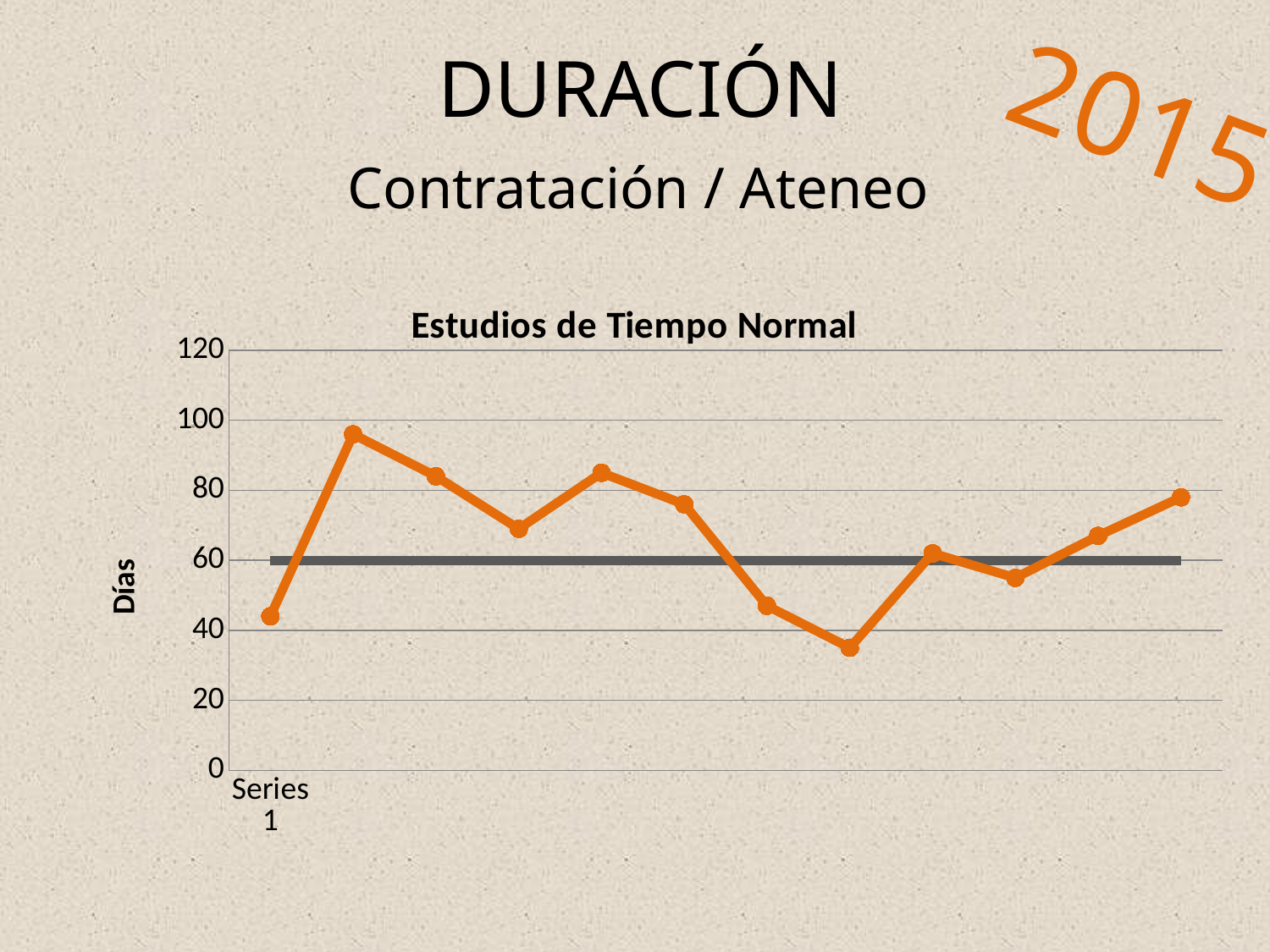
What kind of chart is shown on the slide? line chart At what value on the Días axis does the horizontal gray line sit? 60 Which point on the orange line has the lowest value? the eighth point Is the value of the first point on the orange line greater or less than 60? less What is the title of the chart? Estudios de Tiempo Normal Do the values rise or fall over the last three points of the orange line? rise Is the value of the last point on the orange line greater or less than 60? greater Which point on the orange line has the highest value? the second point How many data points are plotted on the orange line? 12 What is the label on the vertical axis of the chart? Días Is the value of the second point on the orange line greater or less than 80? greater